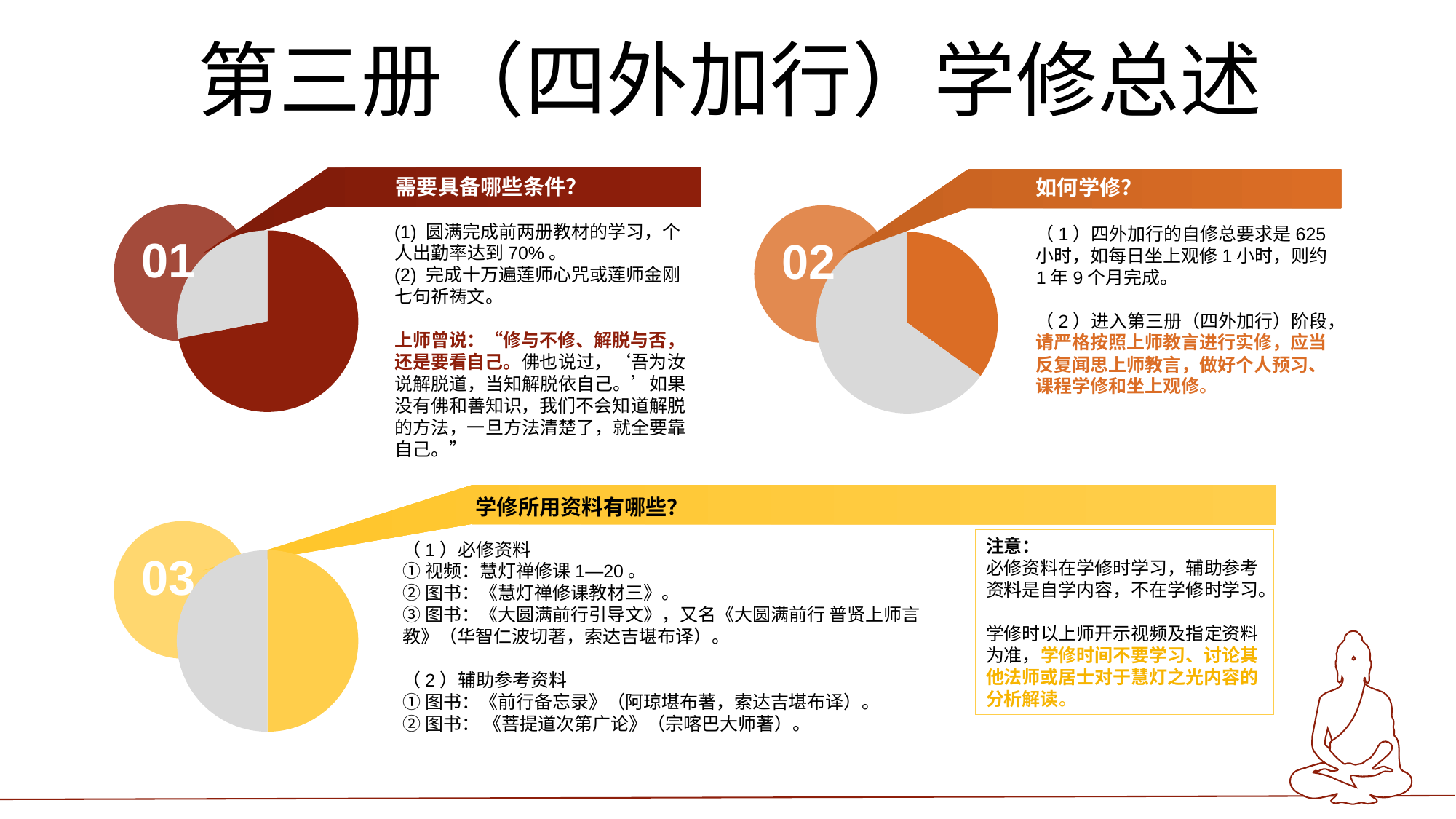
How many slices does the pie chart next to the number 03 have? 2 What colour is the smaller slice of the pie chart next to the number 02? orange How many slices does the pie chart next to the number 02 have? 2 In the pie chart next to the number 01, which slice is larger, the dark red slice or the grey slice? the dark red slice What kind of chart is shown next to the number 01 on the slide? pie chart In the pie chart next to the number 02, which slice is larger, the orange slice or the grey slice? the grey slice What kind of chart is shown next to the number 02 on the slide? pie chart What colour is the larger slice of the pie chart next to the number 01? dark red How many slices does the pie chart next to the number 01 have? 2